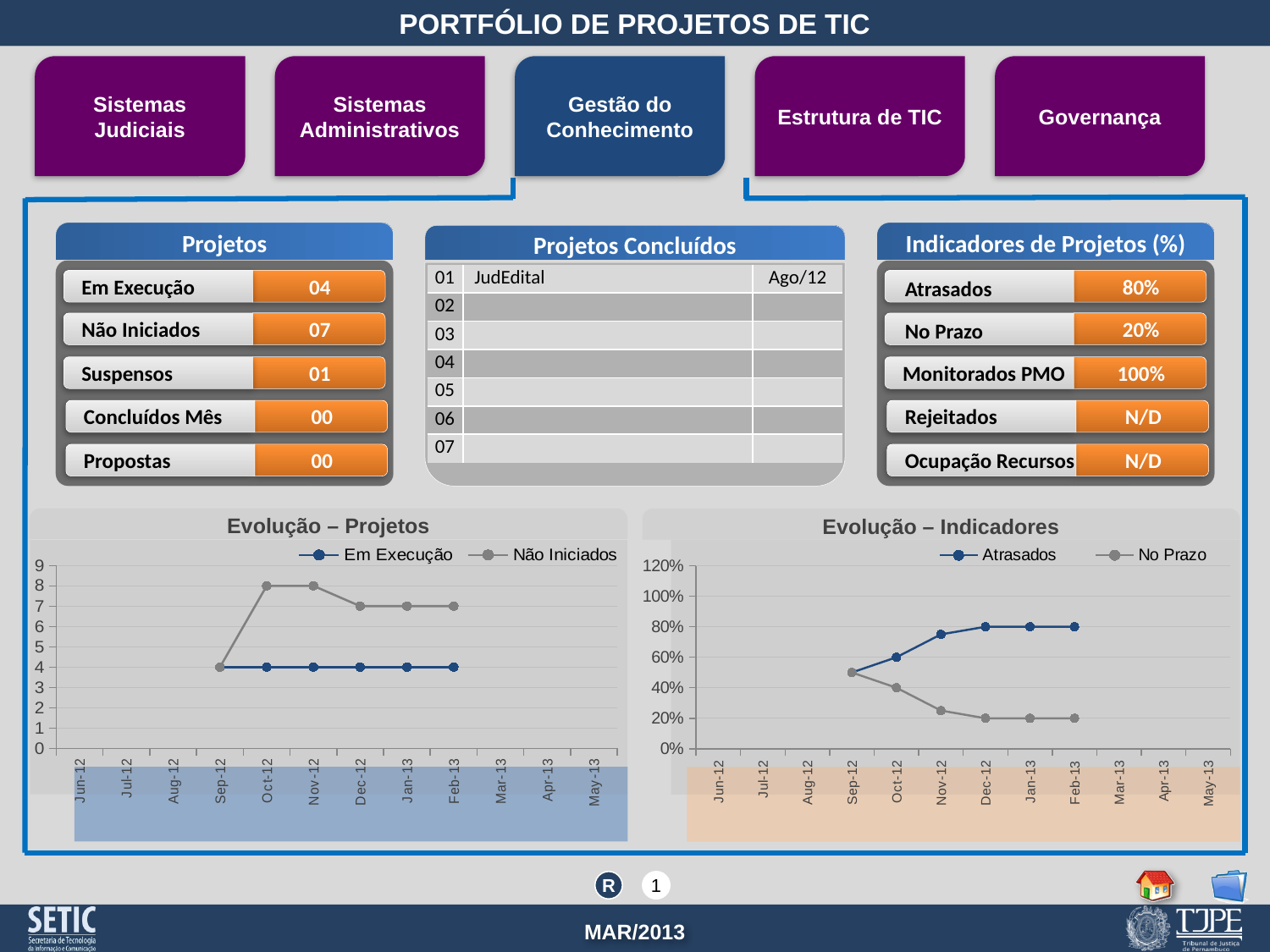
In "Evolução – Projetos", what is the value of Em Execução at Feb-13? 4 In "Evolução – Projetos", what is the value of Não Iniciados at Feb-13? 7 What kind of chart is "Evolução – Projetos"? Line chart In "Evolução – Indicadores", does the Atrasados series rise or fall from Sep-12 to Feb-13? Rises In "Evolução – Indicadores", is the value for Atrasados at Nov-12 greater or less than 60%? greater In "Evolução – Projetos", how many months have plotted data points for the Em Execução series? 6 In "Evolução – Indicadores", what is the value of No Prazo at Oct-12? 40% In "Evolução – Projetos", what is the value of Não Iniciados at Oct-12? 8 In "Evolução – Projetos", what is the difference between Não Iniciados and Em Execução at Nov-12? 4 In "Evolução – Projetos", which series has the higher value at Dec-12, Em Execução or Não Iniciados? Não Iniciados In "Evolução – Indicadores", what is the value of Atrasados at Feb-13? 80% How many series does the legend of "Evolução – Indicadores" list? 2